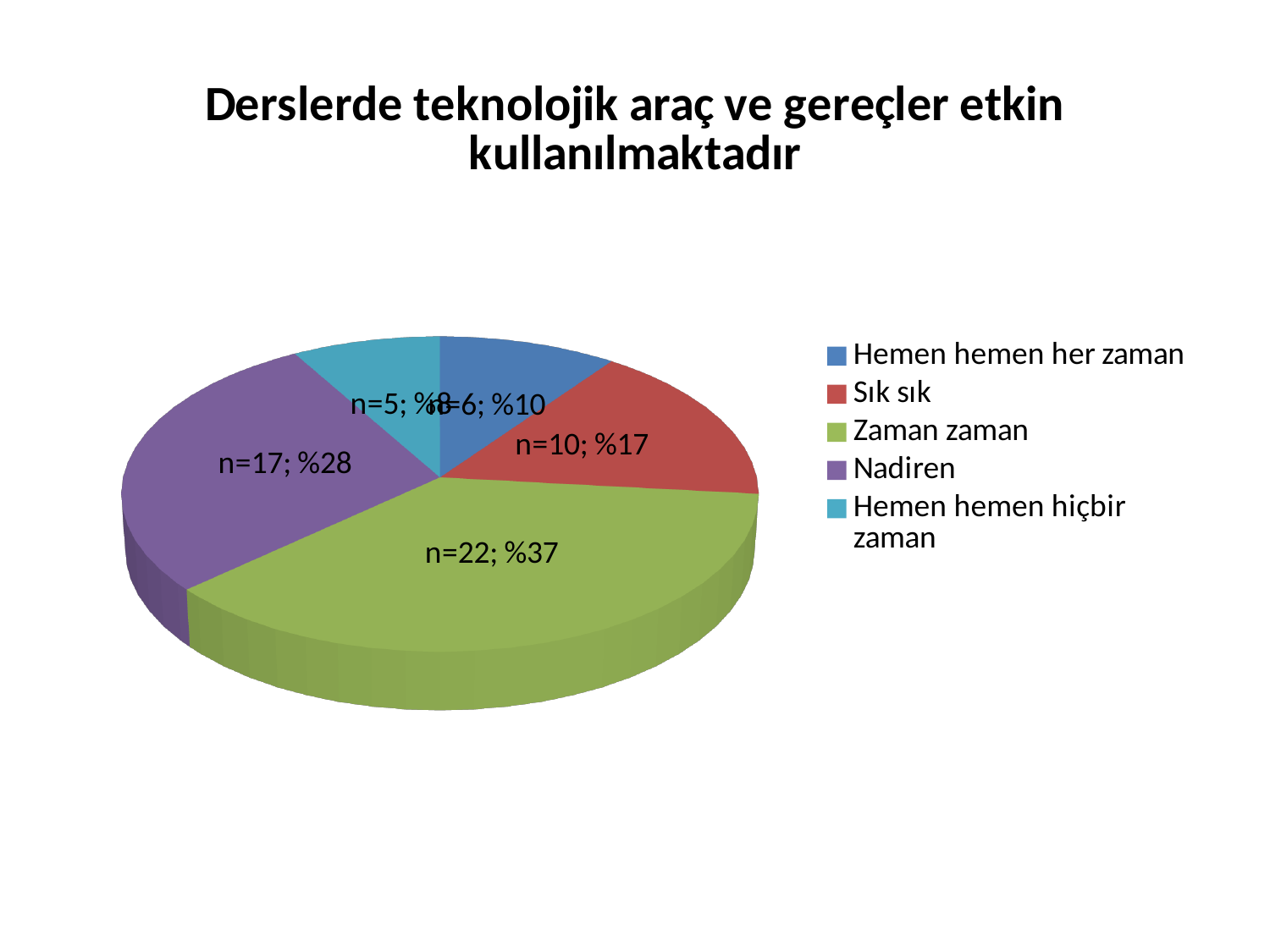
Which slice is larger, 'Nadiren' or 'Sık sık'? Nadiren What percentage share does the 'Hemen hemen her zaman' slice have? %10 What is the n value for the 'Zaman zaman' slice? n=22 How many categories does the legend of the pie chart list? 5 What percentage share does the 'Nadiren' slice have? %28 What kind of chart is shown on the slide? Pie chart Which category has the smallest slice of the pie? Hemen hemen hiçbir zaman What is the difference in n between the 'Zaman zaman' slice and the 'Nadiren' slice? 5 What is the n value for the 'Sık sık' slice? n=10 Which category has the largest slice of the pie? Zaman zaman What is the title of the chart? Derslerde teknolojik araç ve gereçler etkin kullanılmaktadır What percentage share does the 'Zaman zaman' slice have? %37